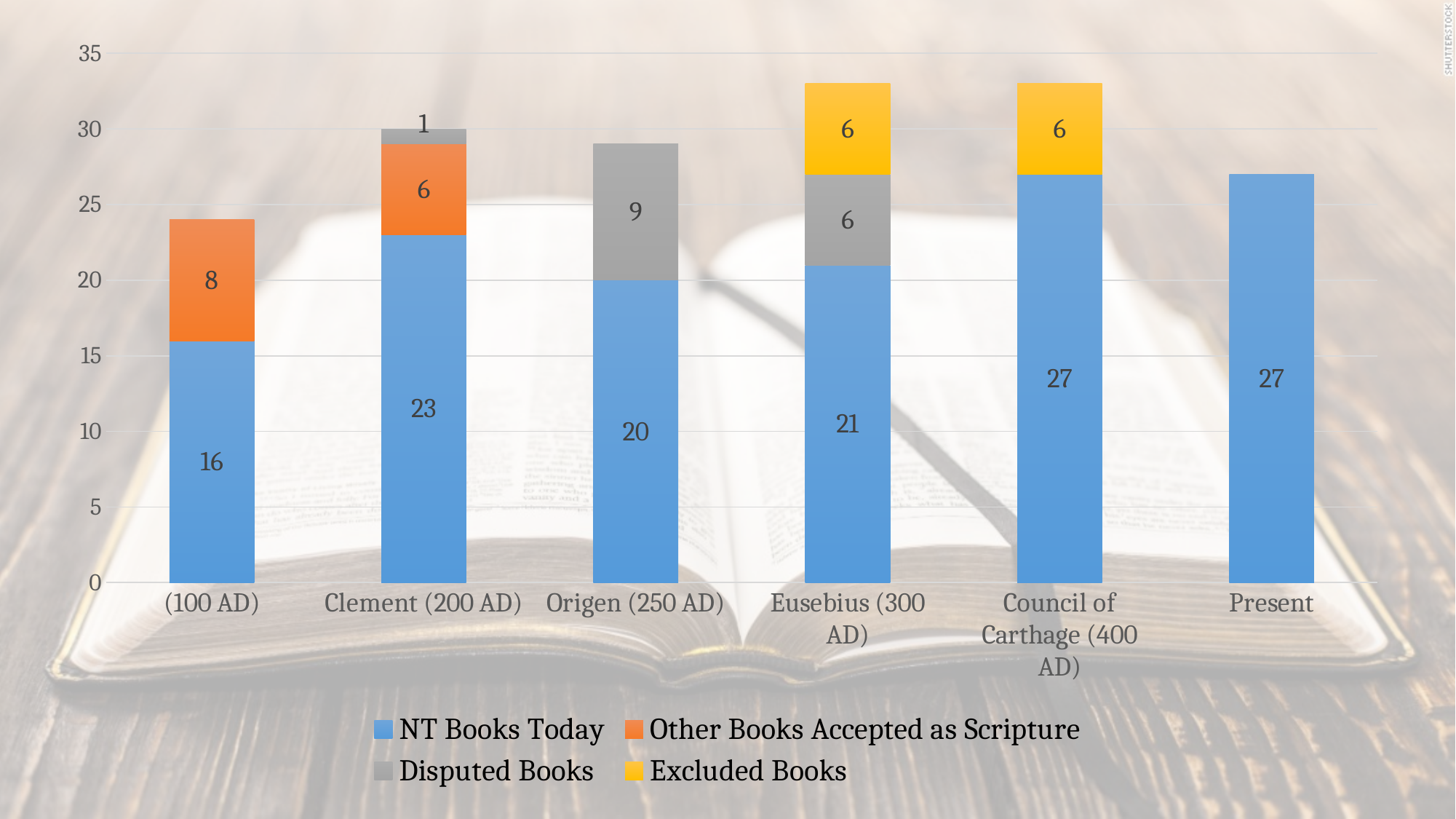
What is the value of NT Books Today for Origen (250 AD)? 20 What is the difference between NT Books Today for Clement (200 AD) and for (100 AD)? 7 Which category has the lowest value for NT Books Today? (100 AD) Which is larger: Disputed Books for Origen (250 AD) or Disputed Books for Eusebius (300 AD)? Origen (250 AD) What is the value of Excluded Books for Eusebius (300 AD)? 6 How many categories are shown along the x axis? 6 Does the value of NT Books Today generally rise or fall from (100 AD) to Present? rise What type of chart is shown on the slide? stacked bar chart What is the value of Other Books Accepted as Scripture for (100 AD)? 8 What is the total of the stacked bar for Eusebius (300 AD)? 33 How many series does the legend list? 4 What is the value of Disputed Books for Clement (200 AD)? 1